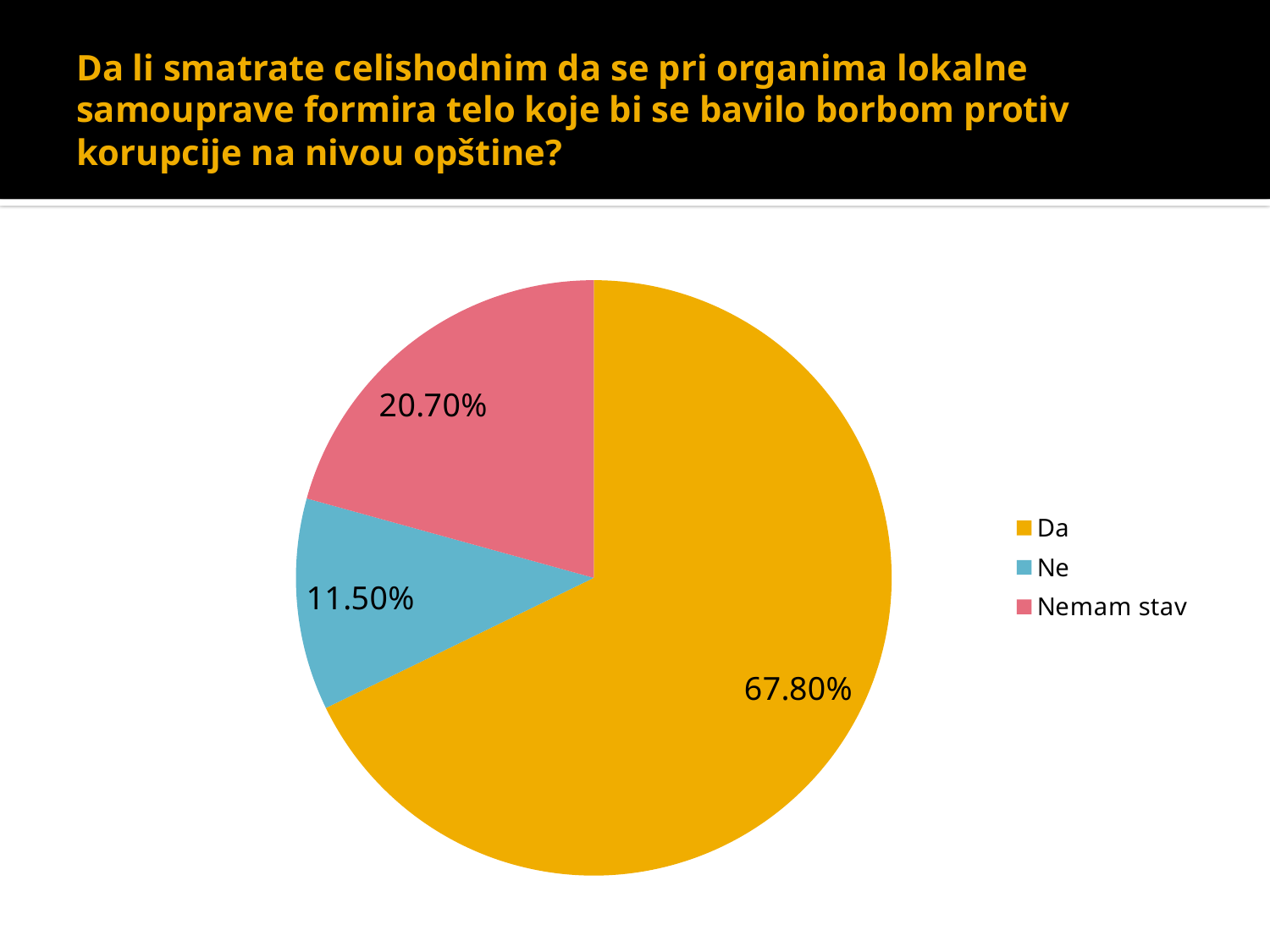
What is the value for "Nemam stav"? 20.70% What colour is the slice for "Ne"? blue What is the difference between the values for "Da" and "Nemam stav"? 47.10% How many categories does the pie chart have? 3 How many entries does the legend list? 3 Which category has the largest share of the pie? Da What kind of chart is shown on the slide? pie chart What is the value for "Da"? 67.80% Which category has the smallest share of the pie? Ne What is the difference between the values for "Nemam stav" and "Ne"? 9.20% Which is larger, the value for "Ne" or the value for "Nemam stav"? Nemam stav What is the value for "Ne"? 11.50%